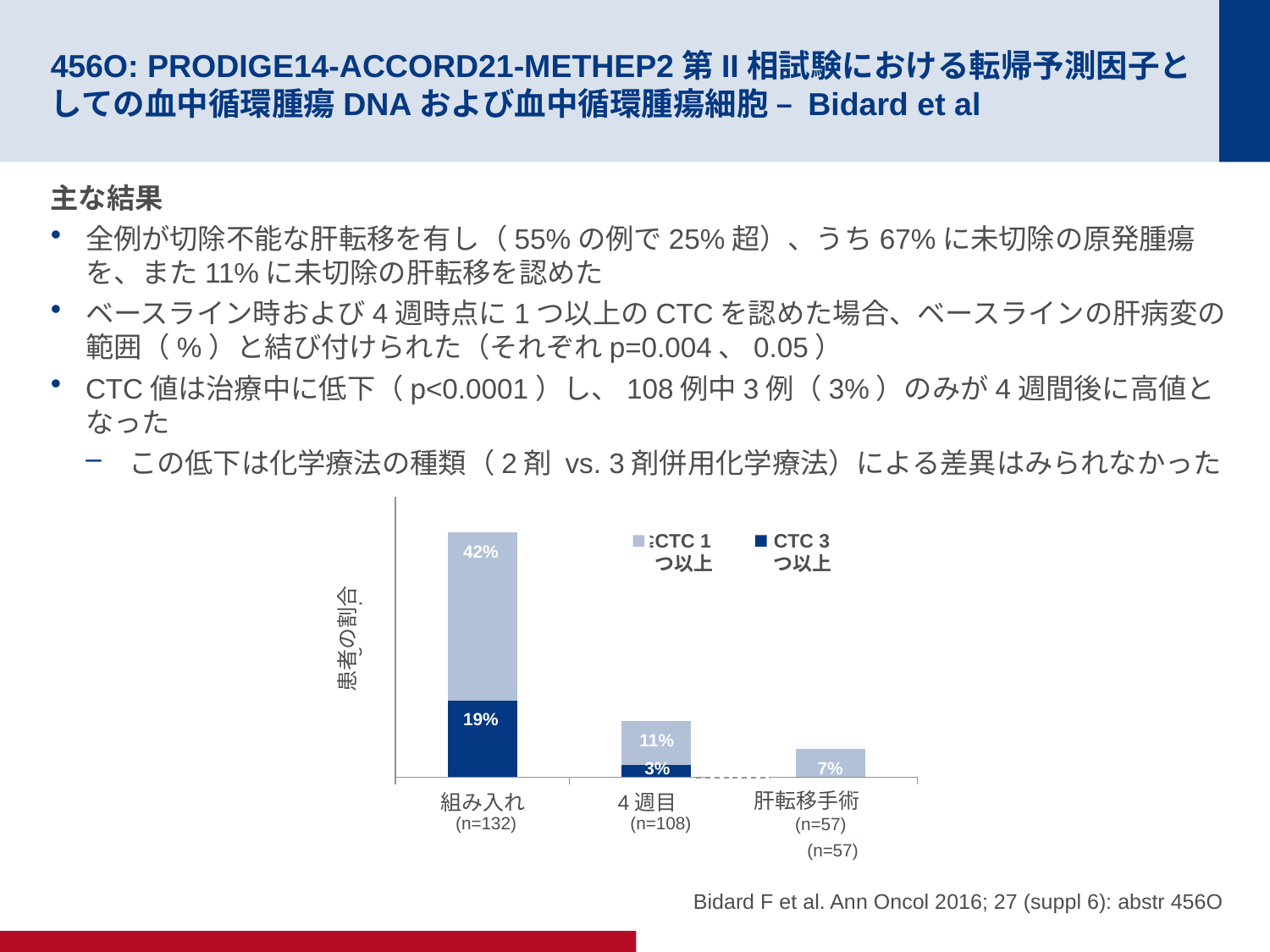
How many categories are shown on the x axis? 3 Do the CTC 1つ以上 values rise or fall from 組み入れ to 肝転移手術? fall What is the difference between the CTC 1つ以上 values at 組み入れ and 4週目? 31 percentage points What is the value for CTC 1つ以上 at 組み入れ? 42% Which category has the highest value for CTC 1つ以上? 組み入れ What is the value for CTC 3つ以上 at 組み入れ? 19% Which is larger for CTC 3つ以上: 組み入れ or 4週目? 組み入れ What is the value for CTC 3つ以上 at 4週目? 3% What is the value for CTC 1つ以上 at 肝転移手術? 7% How many series does the legend list? 2 Which category has the lowest value for CTC 1つ以上? 肝転移手術 What is the value for CTC 1つ以上 at 4週目? 11%